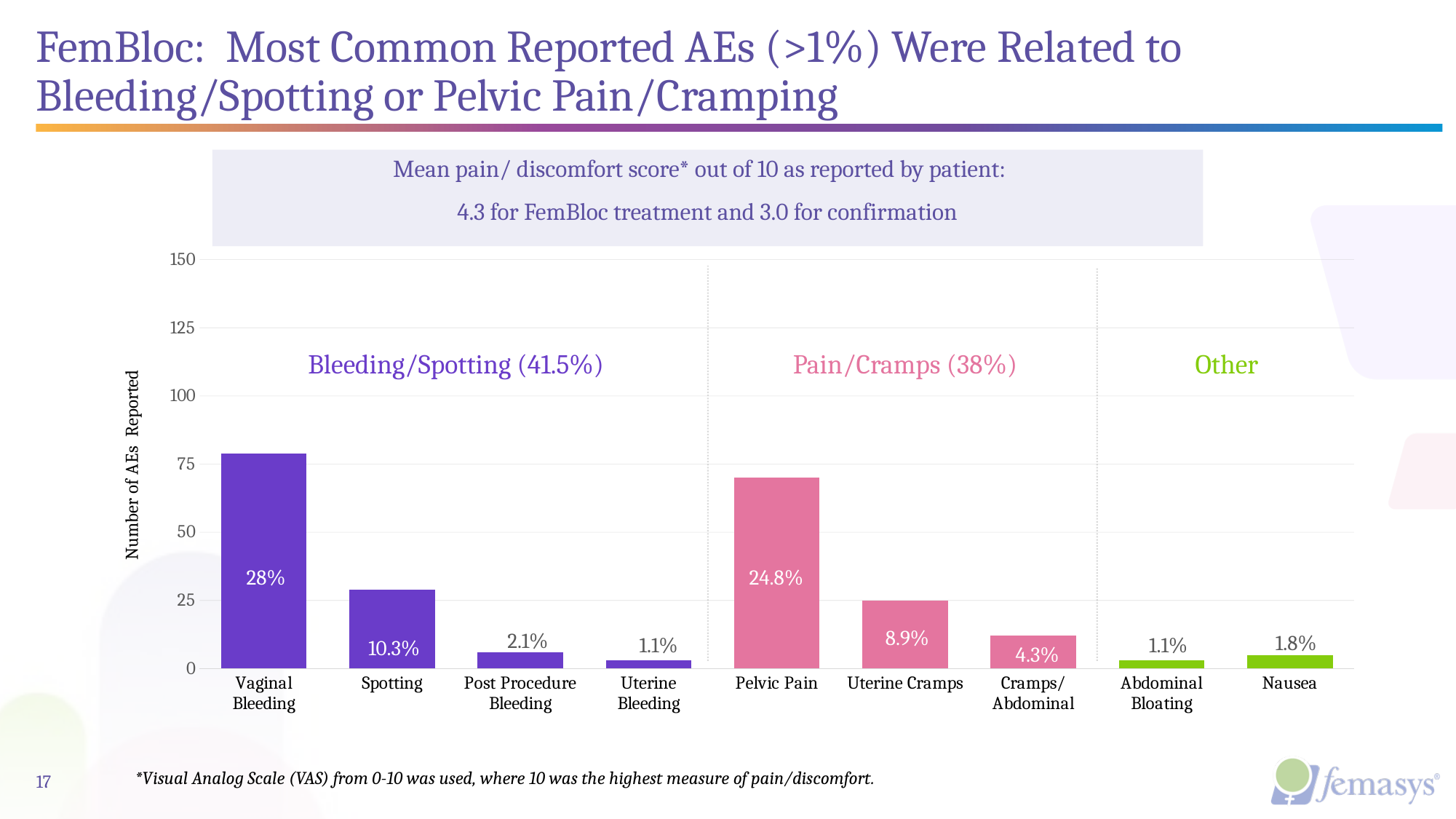
Which is larger, the percentage for Spotting or for Uterine Cramps? Spotting How many adverse event categories are shown on the x axis? 9 Is the number of AEs reported for Vaginal Bleeding greater or less than 50? greater Is the number of AEs reported for Pelvic Pain greater or less than 75? less What percentage label is shown on the Vaginal Bleeding bar? 28% What percentage label is shown for Nausea? 1.8% What percentage label is shown for Uterine Cramps? 8.9% What type of chart is shown on the slide? Bar chart What is the difference in percentage points between the Vaginal Bleeding label (28%) and the Pelvic Pain label (24.8%)? 3.2 percentage points What percentage label is shown on the Pelvic Pain bar? 24.8% What percentage is shown next to the Bleeding/Spotting group label? 41.5% Which adverse event has the tallest bar in the chart? Vaginal Bleeding